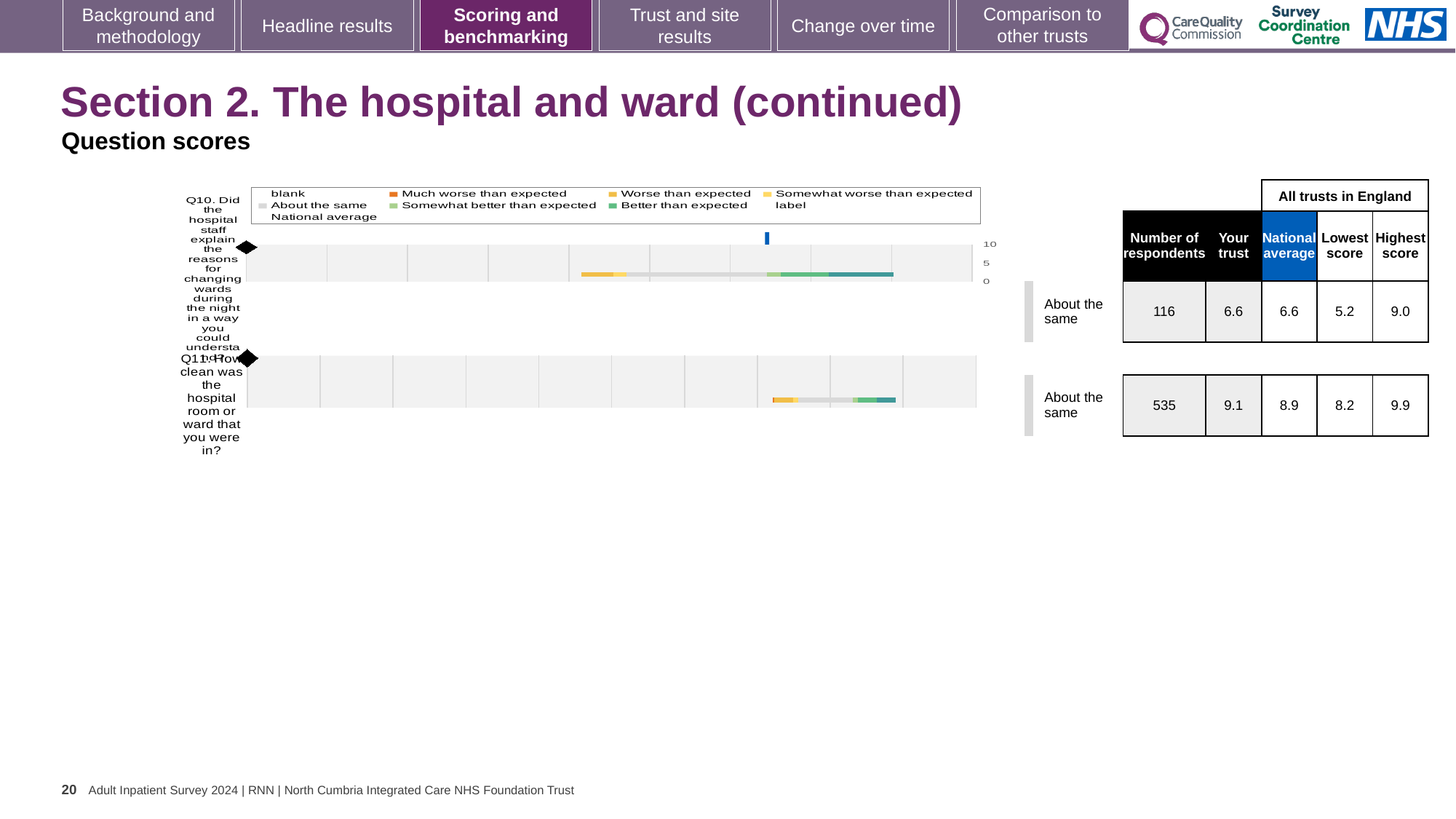
For Q11 (how clean was the hospital room or ward), how many respondents are listed? 535 For Q11, what is the difference between the highest score (9.9) and the lowest score (8.2)? 1.7 What kind of chart is used for the Q10 and Q11 question scores? bar chart For Q11, what is the national average score? 8.9 For Q11, which is larger: your trust score or the national average? your trust (9.1) What benchmark category is given for Q11 (how clean was the hospital room or ward)? About the same How many questions (Q10 and Q11) are plotted on the slide? 2 In the chart legend, which category is shown in grey? About the same For Q10, what is the score for your trust? 6.6 What is the highest value shown on the score axis of the Q10 chart? 10 For Q10 (explaining reasons for changing wards during the night), how many respondents are listed? 116 For Q10, what is the highest score among all trusts in England? 9.0